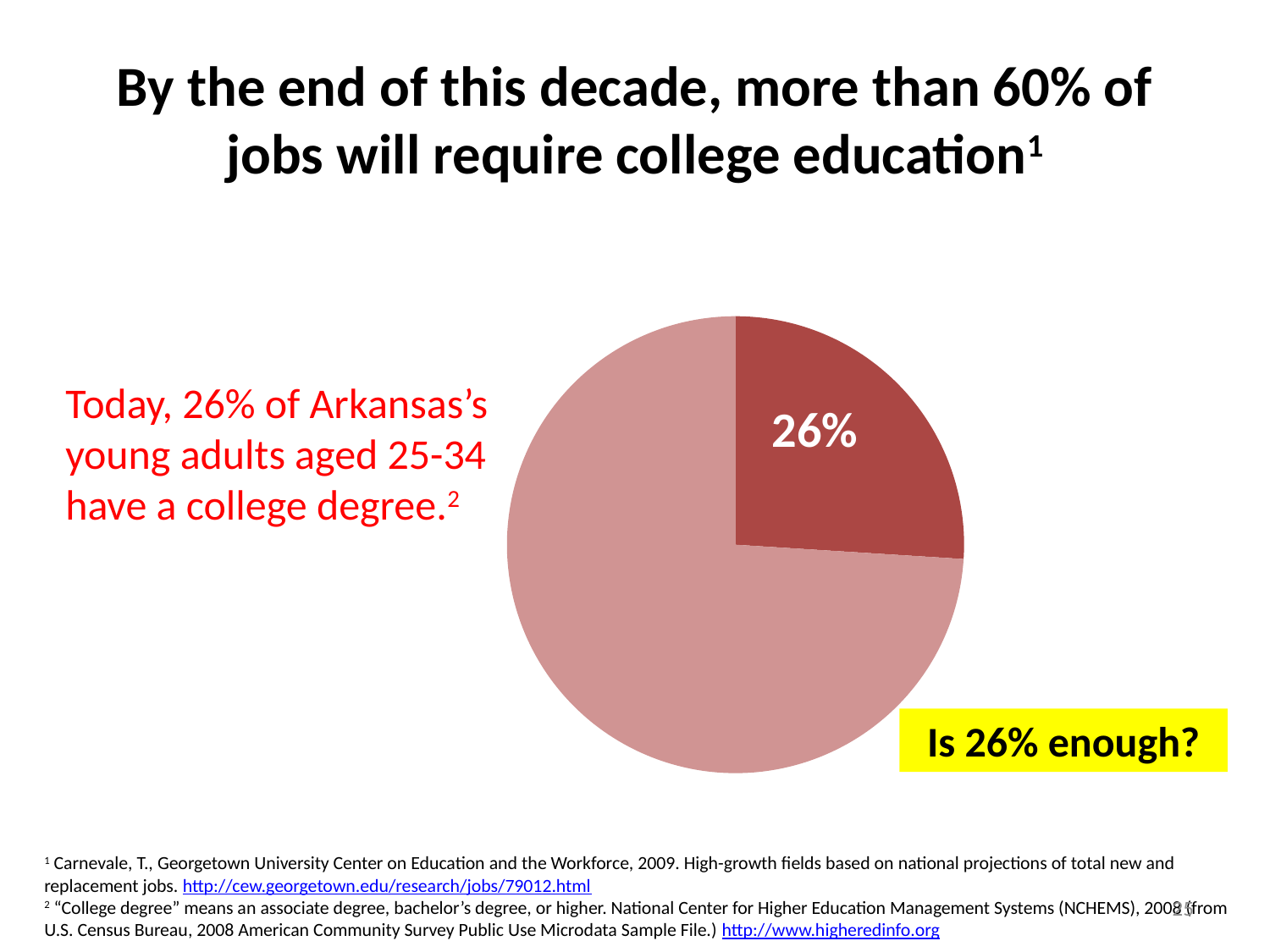
Which slice of the pie chart is the smallest? the darker red slice (26%) What share of the pie does the lighter pink slice represent? 74% Is the share of the darker red slice greater or less than 50%? less What kind of chart is shown on the slide? pie chart What percentage is printed on the darker slice of the pie chart? 26% What share of the pie does the darker red slice represent? 26% Which slice of the pie chart is larger, the darker red slice or the lighter pink slice? the lighter pink slice What colour is the slice labelled 26%? dark red How many slices does the pie chart have? 2 According to the slide, what percentage of Arkansas's young adults aged 25-34 have a college degree? 26% What question is written in the yellow box next to the pie chart? Is 26% enough?